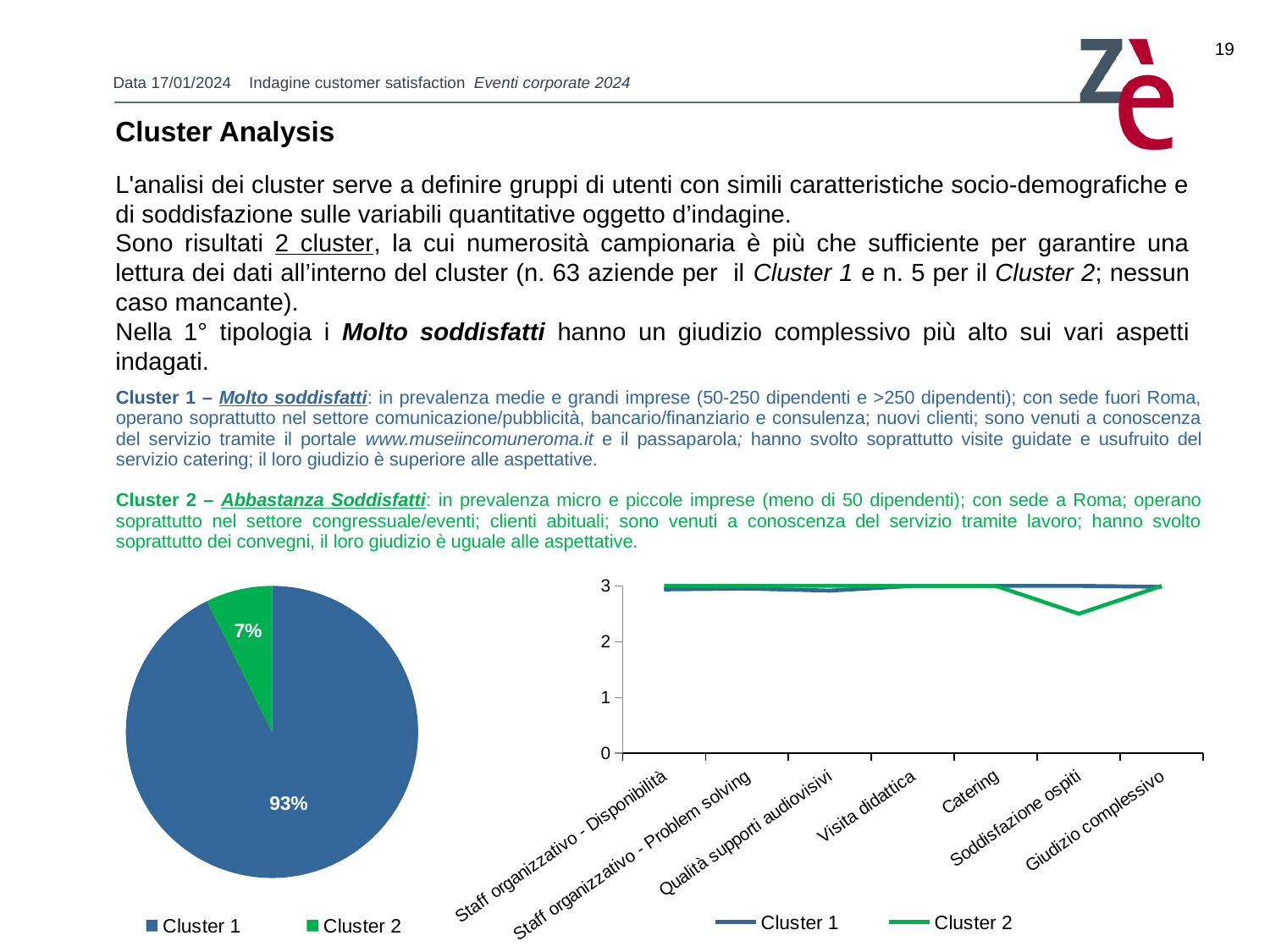
In the line chart on the right, is the value of Cluster 1 for Giudizio complessivo greater or less than 2? greater What kind of chart is the chart on the left of the slide? Pie chart In the line chart on the right, is the value of Cluster 2 for Soddisfazione ospiti greater or less than 3? less What kind of chart is the chart on the right of the slide? Line chart In the line chart on the right, how many series does the legend list? 2 In the pie chart on the left, what share does Cluster 2 have? 7% In the pie chart on the left, what share does Cluster 1 have? 93% In the pie chart on the left, how many slices are there? 2 In the line chart on the right, which series is drawn in green? Cluster 2 In the pie chart on the left, what is the difference in percentage points between the Cluster 1 and Cluster 2 slices? 86 In the line chart on the right, how many categories are shown on the x axis? 7 In the pie chart on the left, which cluster has the larger slice? Cluster 1